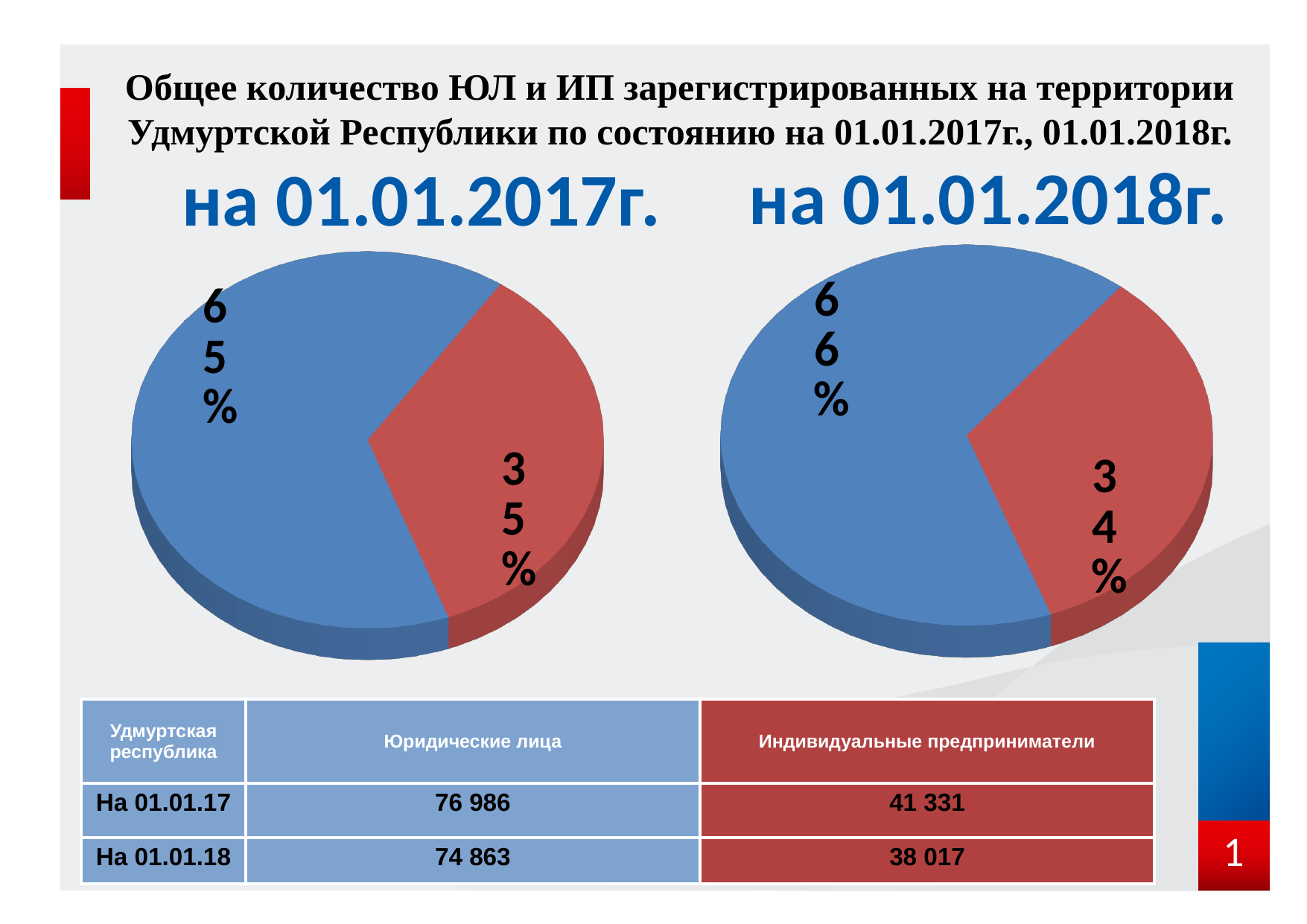
In the pie chart for 01.01.2017, what share does the blue slice have? 65% How many slices does the pie chart for 01.01.2018 have? 2 Is the blue slice's share in the pie chart for 01.01.2018 greater or less than 50%? greater In the pie chart for 01.01.2018, what share does the red slice have? 34% In the pie chart for 01.01.2017, which slice is larger, the blue one or the red one? the blue one Comparing the two pie charts, did the red slice's share rise or fall from 01.01.2017 to 01.01.2018? fall In the pie chart for 01.01.2017, what is the difference between the blue slice's share and the red slice's share? 30% In the pie chart for 01.01.2018, what share does the blue slice have? 66% What kind of chart is shown under the heading "на 01.01.2017г."? pie chart In the pie chart for 01.01.2017, what share does the red slice have? 35% How many pie charts are shown on the slide? 2 In the pie chart for 01.01.2018, which slice is the smallest? the red slice (34%)